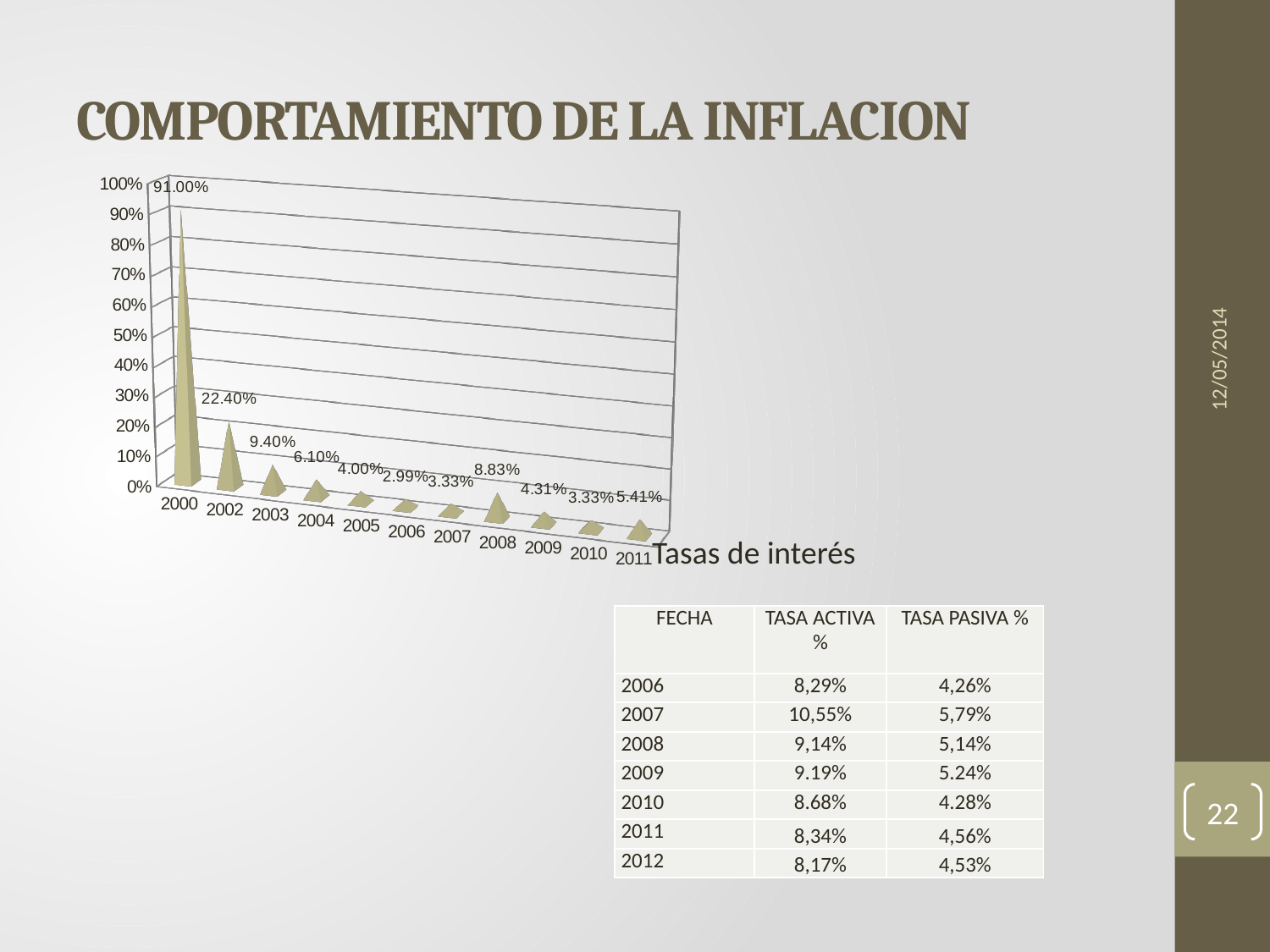
Which is larger in the chart, the value for 2008 or the value for 2009? 2008 What is the title of the slide containing the chart? COMPORTAMIENTO DE LA INFLACION How many years are plotted in the chart? 11 Do the values in the chart generally rise or fall from 2000 to 2006? fall Which year has the highest value in the chart? 2000 What is the value shown for 2000 in the chart? 91.00% Is the value for 2002 in the chart greater or less than 30%? less What is the difference between the values for 2000 and 2002 in the chart? 68.60% What is the value shown for 2002 in the chart? 22.40% Which year has the lowest value in the chart? 2006 What is the value shown for 2008 in the chart? 8.83% What is the value shown for 2011 in the chart? 5.41%